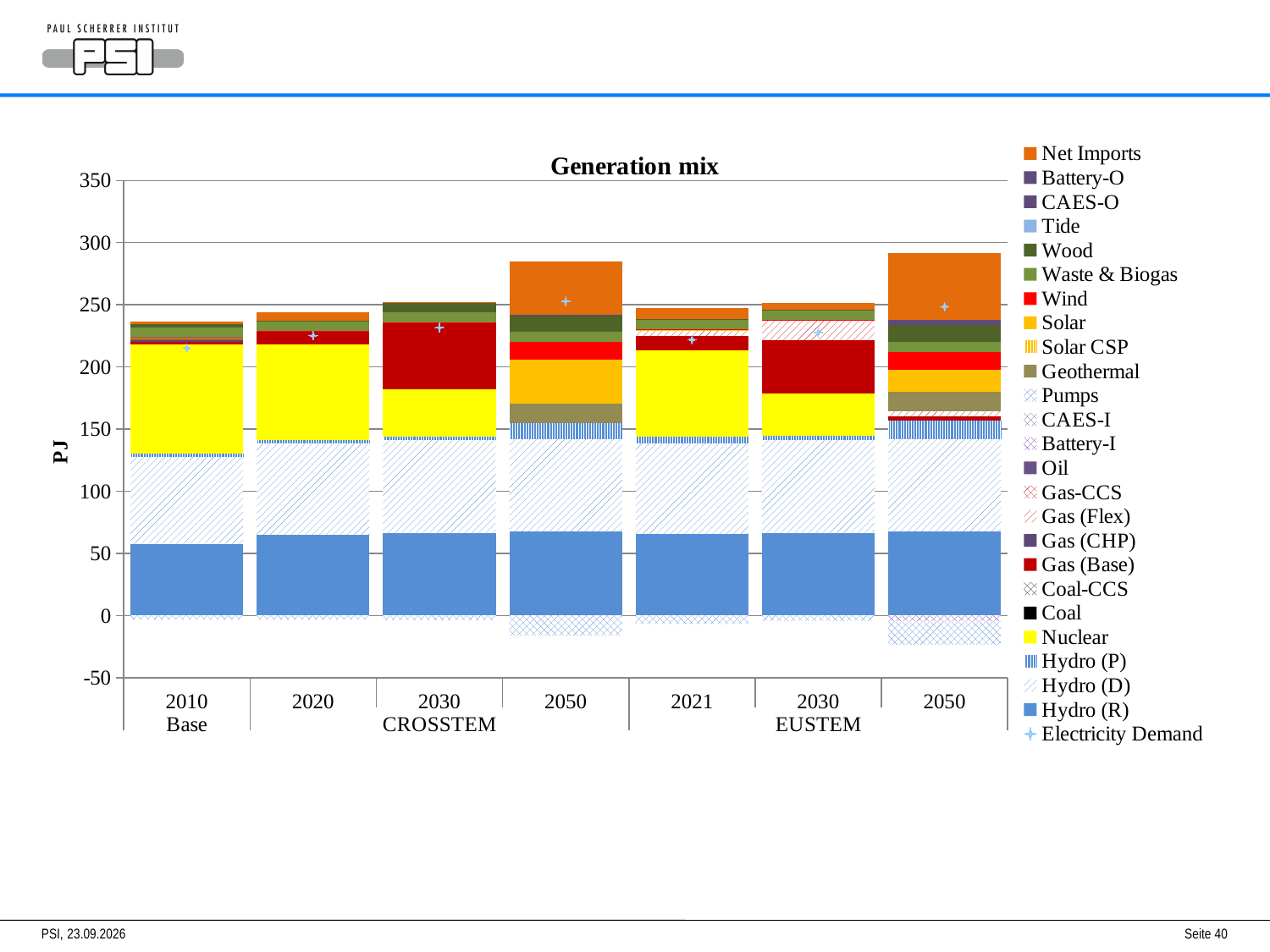
Which bar has the larger Net Imports segment, 2010 Base or 2050 CROSSTEM? 2050 CROSSTEM Is the Hydro (R) value in the 2010 Base bar greater or less than 50 PJ? greater How many bars (year categories) are plotted in the chart? 7 Does the total generation rise or fall from 2021 to 2050 in the EUSTEM scenario? Rise How many entries does the legend list? 25 Is the total height of the 2050 EUSTEM bar greater or less than 250 PJ? greater Is the total height of the 2010 Base bar greater or less than 250 PJ? less What is the title of the chart? Generation mix Which bar has the larger Nuclear segment, 2020 CROSSTEM or 2050 CROSSTEM? 2020 CROSSTEM What kind of chart is shown on the slide? Stacked bar chart What is the label on the y axis of the chart? PJ